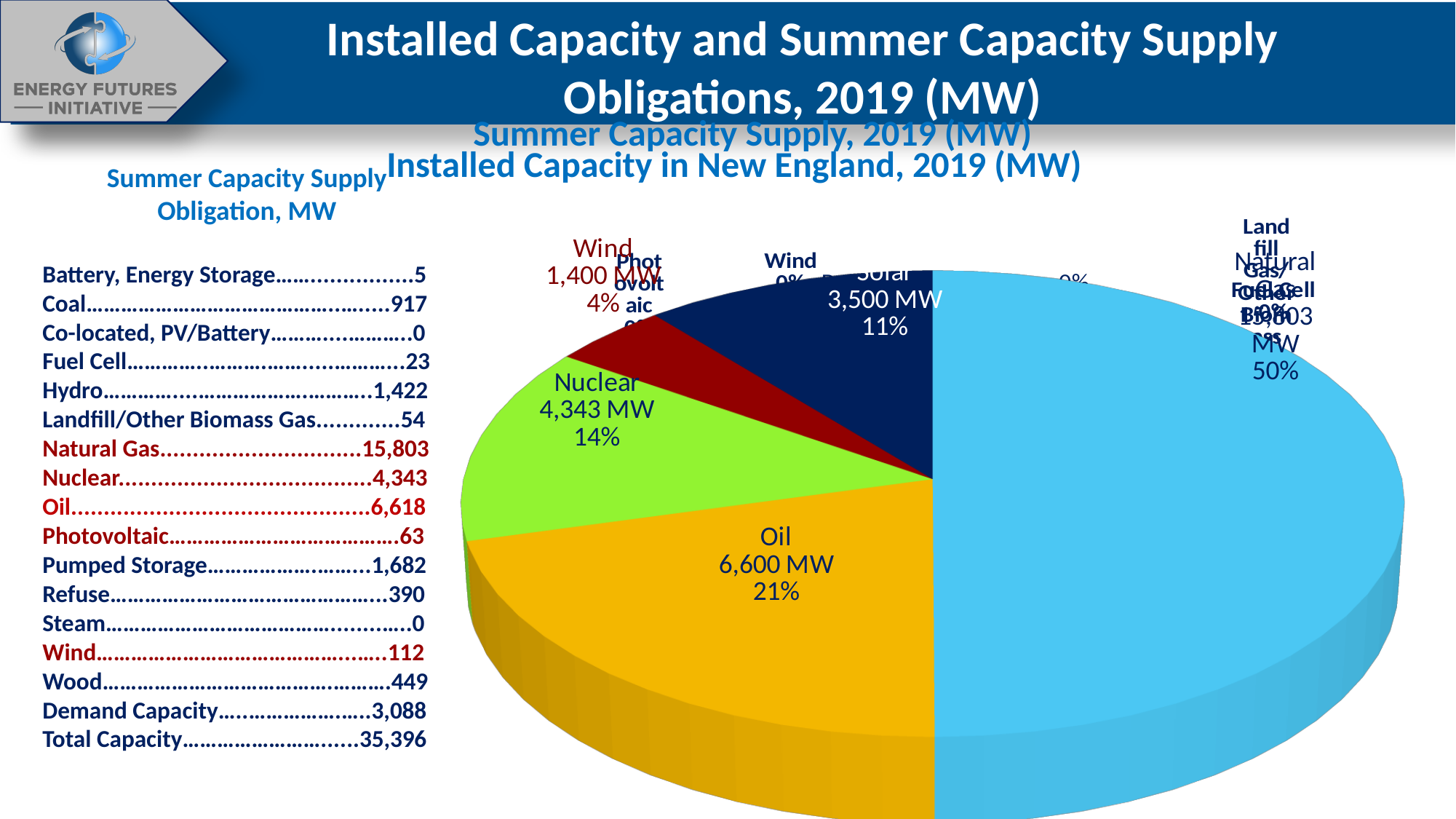
What percentage share of the pie does Solar represent? 11% What is the installed capacity value shown for Wind in the pie chart? 1,400 MW What percentage share of the pie does Nuclear represent? 14% What kind of chart is shown on the slide? pie chart What percentage share of the pie does Oil represent? 21% What percentage share of the pie does the largest slice represent? 50% What is the installed capacity value shown for Solar in the pie chart? 3,500 MW What is the installed capacity value shown for Oil in the pie chart? 6,600 MW What is the installed capacity value shown for Nuclear in the pie chart? 4,343 MW What colour is the Nuclear slice in the pie chart? green What is the difference in MW between the Oil slice and the Nuclear slice? 2,257 MW Which slice is larger in the pie chart, Oil or Nuclear? Oil